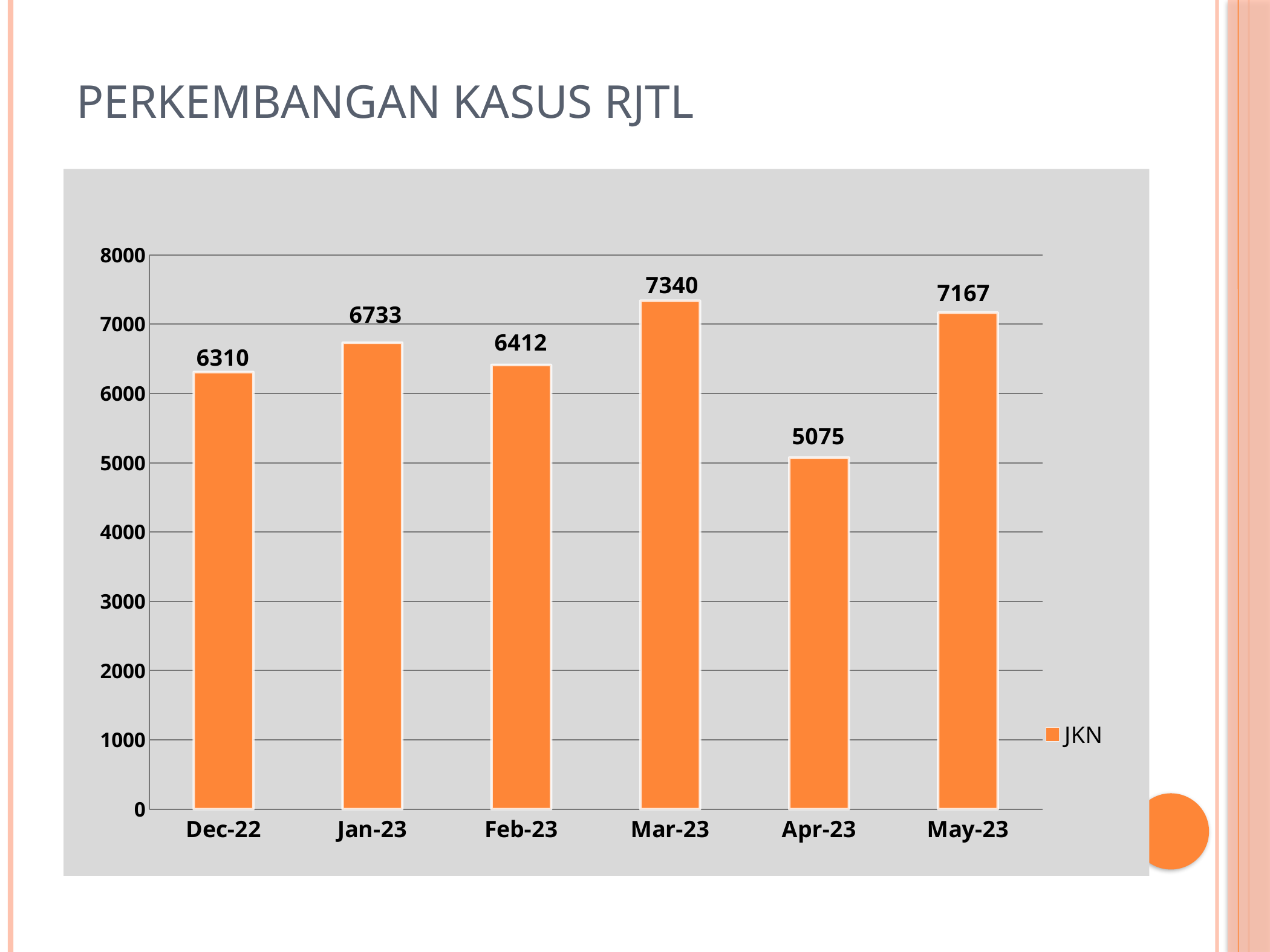
What is the difference between the values for Mar-23 and Apr-23? 2265 What is the value for Mar-23? 7340 How many months are shown on the x axis? 6 What kind of chart is shown on the slide? bar chart What series name does the legend show? JKN What is the value for Dec-22? 6310 Is the value for Apr-23 greater or less than 6000? less Which month has the highest value? Mar-23 What is the difference between the values for Jan-23 and Feb-23? 321 Which is larger, the value for May-23 or the value for Jan-23? May-23 Which month has the lowest value? Apr-23 What is the value for Apr-23? 5075